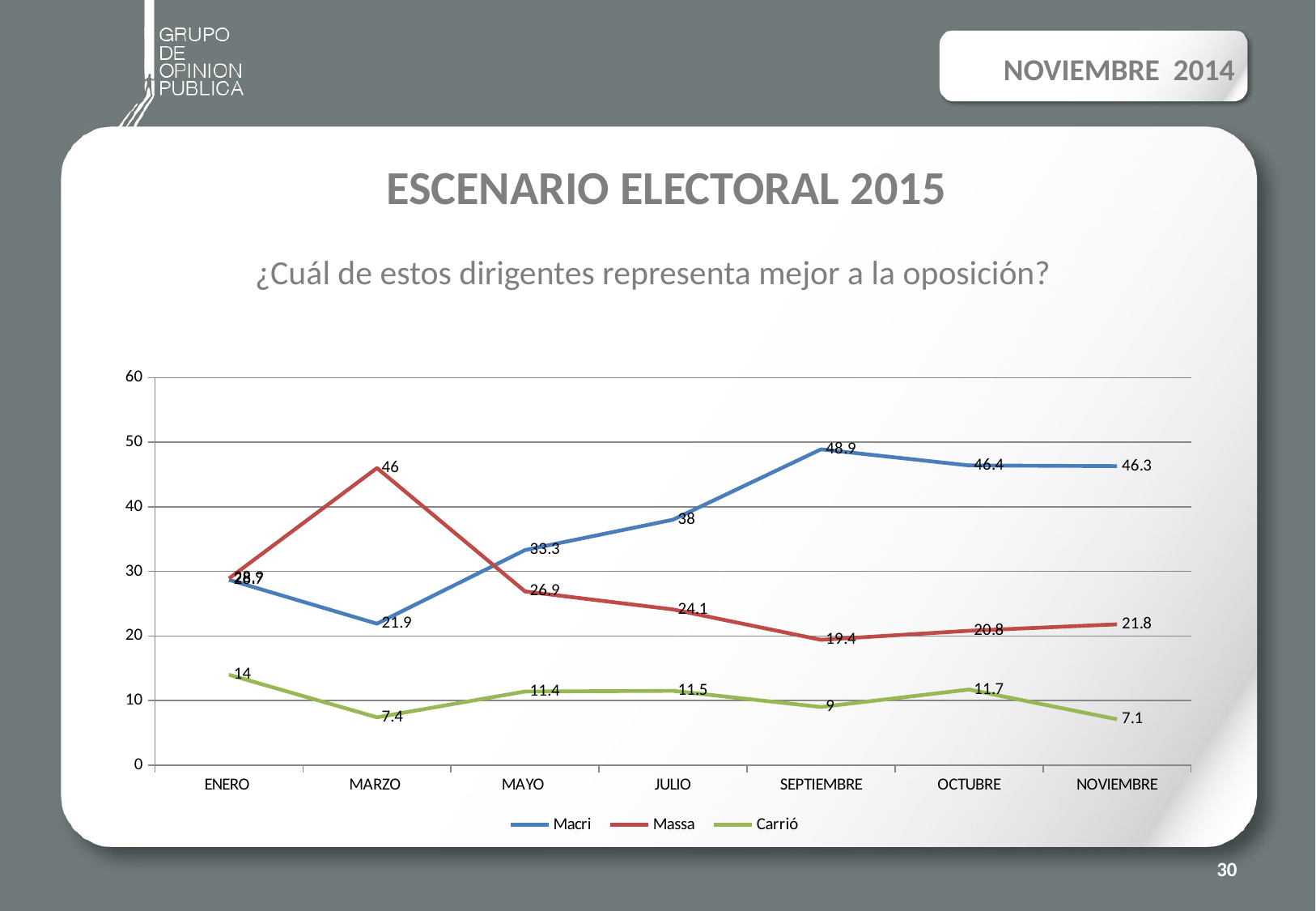
What is the value for Macri in SEPTIEMBRE? 48.9 Which series is drawn in green in the chart? Carrió In which month does Macri reach its highest value? SEPTIEMBRE What is the value for Massa in MARZO? 46 Which is larger in MARZO, the value for Macri or the value for Massa? Massa In which month does Carrió have its lowest value? NOVIEMBRE What is the value for Carrió in NOVIEMBRE? 7.1 How many series does the legend list? 3 What is the difference between Macri and Massa in NOVIEMBRE? 24.5 How many months are plotted along the x axis? 7 What kind of chart is shown on the slide? line chart Does the value for Massa rise or fall from MARZO to SEPTIEMBRE? fall